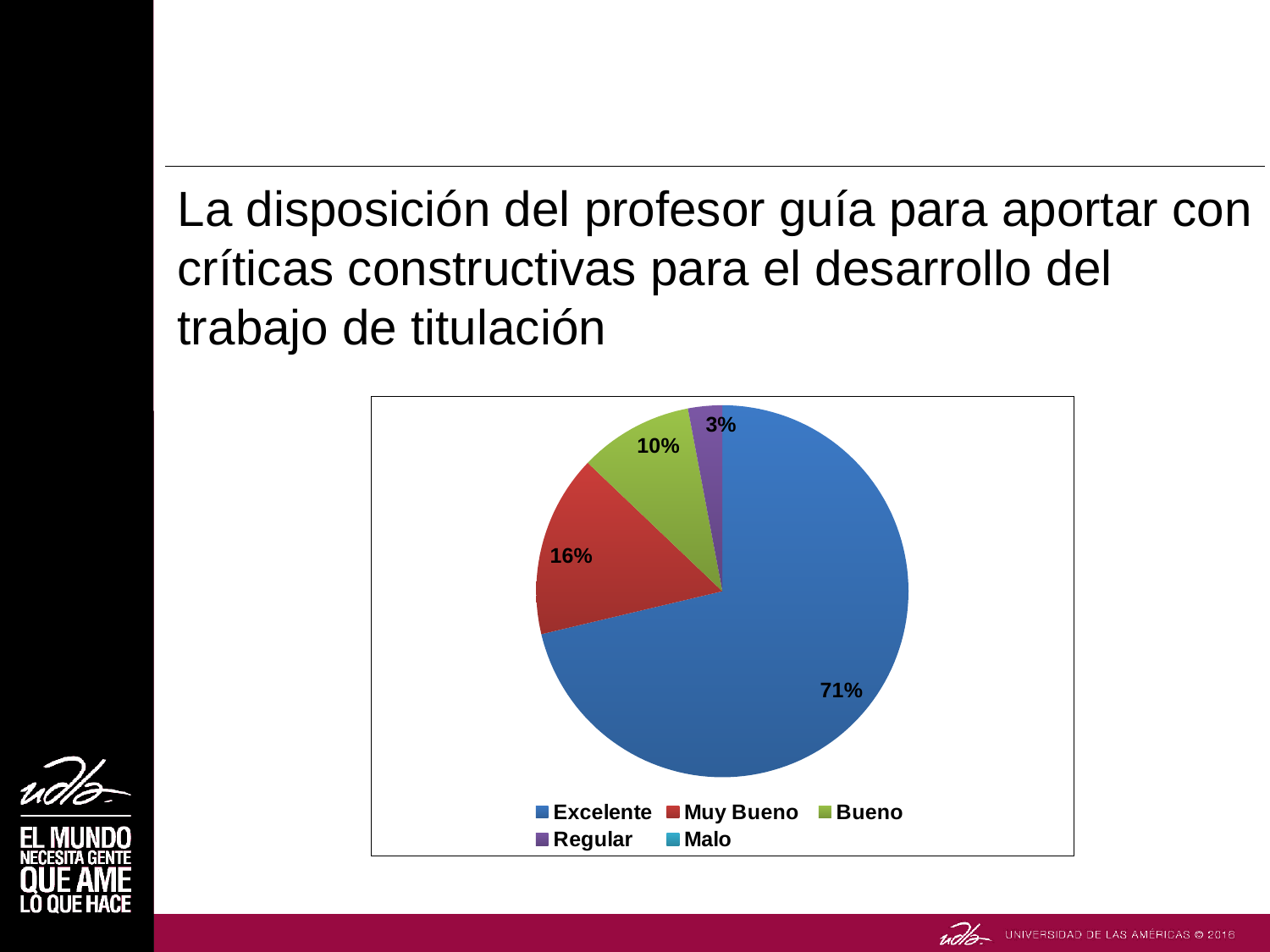
What percentage of the pie corresponds to Bueno? 10% Which category has the largest share of the pie? Excelente What percentage of the pie corresponds to Muy Bueno? 16% What percentage of the pie corresponds to Regular? 3% What is the difference in percentage points between Excelente and Muy Bueno? 55 How many categories does the legend list? 5 What percentage of the pie corresponds to Excelente? 71% What colour is the Excelente slice? blue What colour is the Muy Bueno slice? red Which of the labelled slices has the smallest share of the pie? Regular What kind of chart is shown on the slide? pie chart Which is larger, the share for Bueno or the share for Regular? Bueno